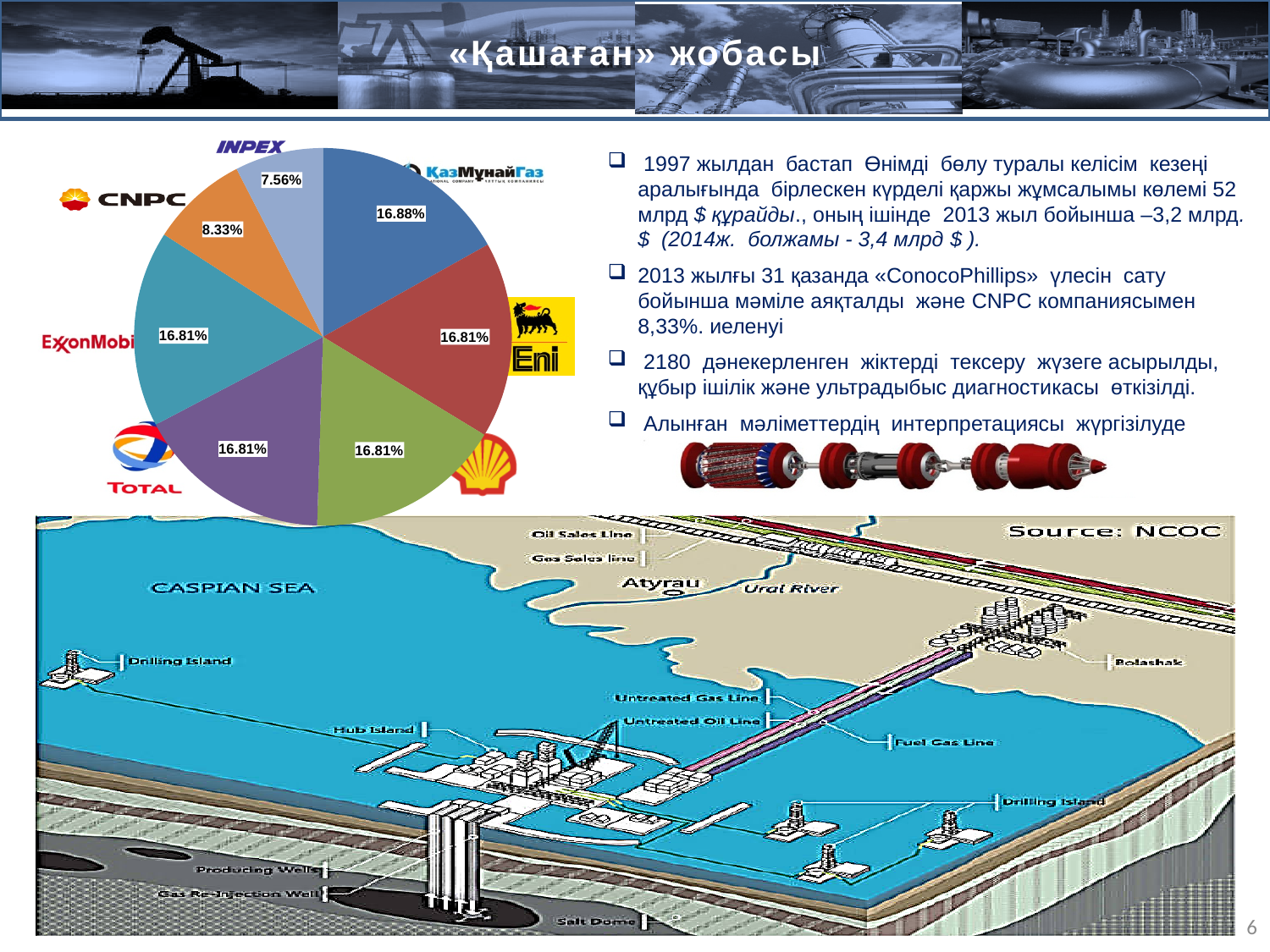
What share of the pie does the Eni slice have? 16.81% How many slices does the pie chart have? 7 What share of the pie does the INPEX slice have? 7.56% What share of the pie does the Total slice have? 16.81% What share of the pie does the ExxonMobil slice have? 16.81% What share of the pie does the CNPC slice have? 8.33% What kind of chart is shown on the slide? pie chart What is the difference between the CNPC share and the INPEX share? 0.77% What share of the pie does the KazMunayGas slice have? 16.88% Which company has the smallest slice of the pie? INPEX Which company has the largest slice of the pie according to the printed labels? KazMunayGas Which slice is larger, CNPC or INPEX? CNPC